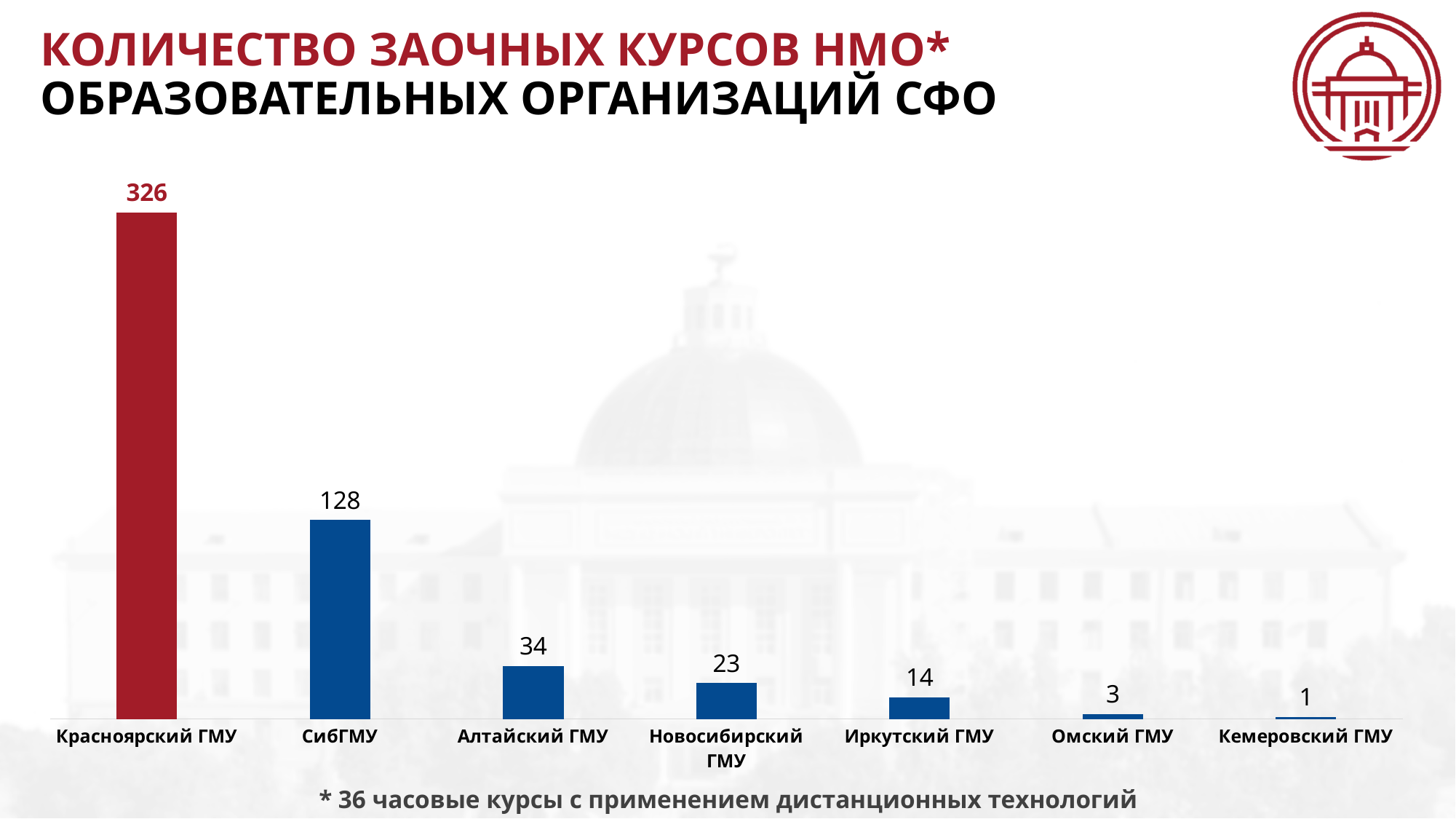
What kind of chart is shown on the slide? Bar chart Which has a larger value, Алтайский ГМУ or Новосибирский ГМУ? Алтайский ГМУ What is the difference between the values for Красноярский ГМУ and СибГМУ? 198 What is the value for Красноярский ГМУ? 326 What is the difference between the values for Алтайский ГМУ and Иркутский ГМУ? 20 Which organisation has the highest number of courses? Красноярский ГМУ What is the value for СибГМУ? 128 What is the value for Новосибирский ГМУ? 23 How many organisations are shown in the chart? 7 Which bar is coloured red rather than blue? Красноярский ГМУ What is the value for Омский ГМУ? 3 Which organisation has the lowest number of courses? Кемеровский ГМУ